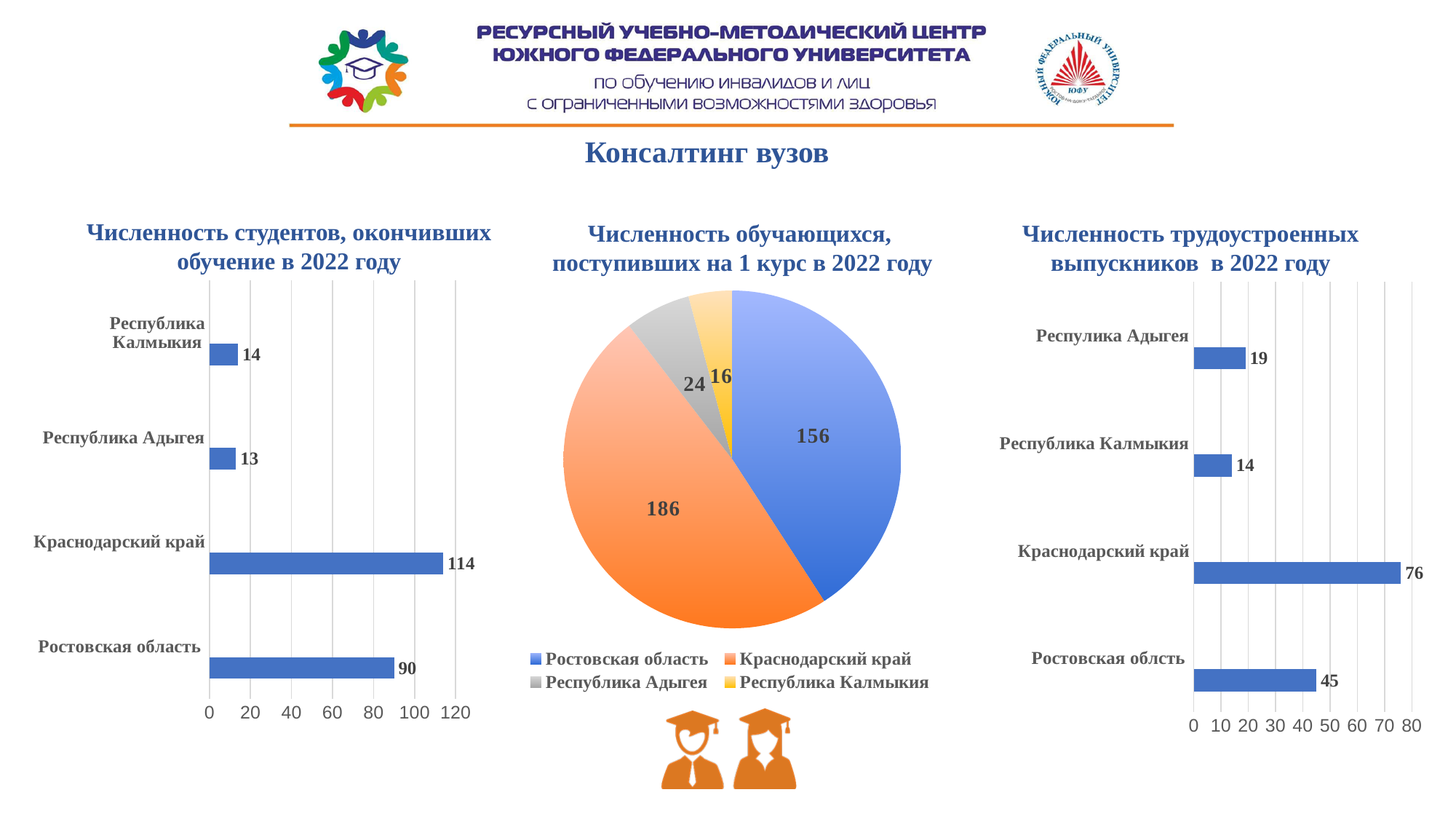
In the right chart 'Численность трудоустроенных выпускников в 2022 году', which is larger: Республика Адыгея or Республика Калмыкия? Республика Адыгея In the middle chart 'Численность обучающихся, поступивших на 1 курс в 2022 году', what is the total of all slices? 382 In the right chart 'Численность трудоустроенных выпускников в 2022 году', what is the value for Ростовская область? 45 What kind of chart is the middle chart 'Численность обучающихся, поступивших на 1 курс в 2022 году'? pie chart In the middle chart 'Численность обучающихся, поступивших на 1 курс в 2022 году', which region has the largest slice? Краснодарский край In the middle chart 'Численность обучающихся, поступивших на 1 курс в 2022 году', which colour represents Республика Калмыкия? yellow In the left chart 'Численность студентов, окончивших обучение в 2022 году', which region has the lowest value? Республика Адыгея In the left chart 'Численность студентов, окончивших обучение в 2022 году', what is the value for Краснодарский край? 114 In the middle chart 'Численность обучающихся, поступивших на 1 курс в 2022 году', what is the value for Краснодарский край? 186 In the left chart 'Численность студентов, окончивших обучение в 2022 году', what is the difference between Краснодарский край and Ростовская область? 24 What kind of chart is the right chart 'Численность трудоустроенных выпускников в 2022 году'? bar chart In the left chart 'Численность студентов, окончивших обучение в 2022 году', how many regions are shown? 4